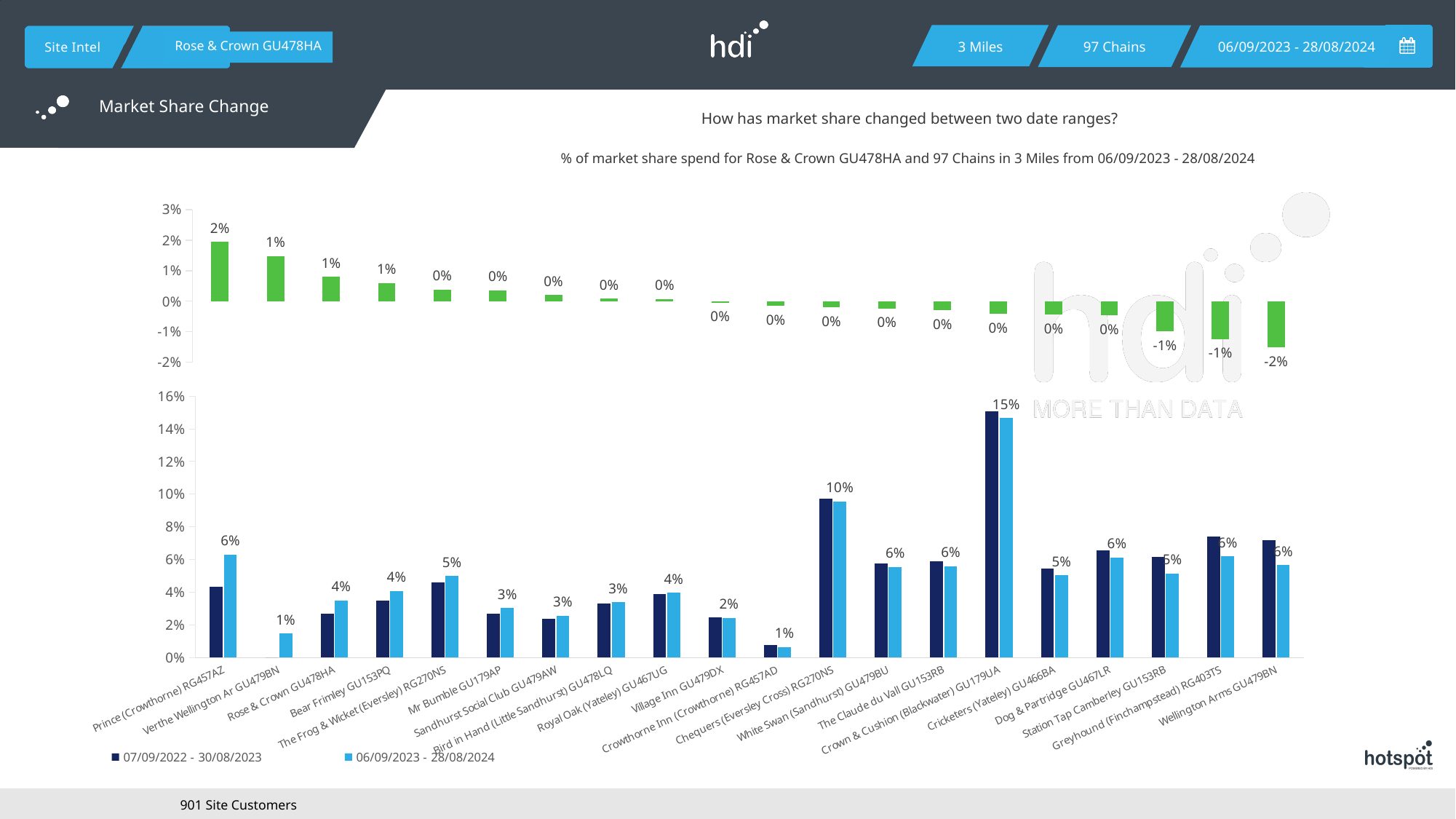
How many series does the legend of the bottom chart list? 2 On the top chart (market share change), what is the value for Wellington Arms GU479BN? -2% On the top chart (market share change), what is the difference between the values for Prince (Crowthorne) RG457AZ and Wellington Arms GU479BN? 4% On the bottom chart, what is the labelled value for Chequers (Eversley Cross) RG270NS in the 06/09/2023 - 28/08/2024 series? 10% On the bottom chart, is the 07/09/2022 - 30/08/2023 value for Crown & Cushion (Blackwater) GU179UA greater or less than 14%? greater On the bottom chart, what is the labelled value for Crown & Cushion (Blackwater) GU179UA in the 06/09/2023 - 28/08/2024 series? 15% On the top chart (market share change), which venue has the lowest value? Wellington Arms GU479BN On the top chart (market share change), what is the value for Prince (Crowthorne) RG457AZ? 2% On the bottom chart, for Prince (Crowthorne) RG457AZ, which series has the larger value: 07/09/2022 - 30/08/2023 or 06/09/2023 - 28/08/2024? 06/09/2023 - 28/08/2024 How many venues are shown on the bottom chart? 20 On the top chart (market share change), which venue has the highest value? Prince (Crowthorne) RG457AZ What kind of chart is the bottom chart? Bar chart